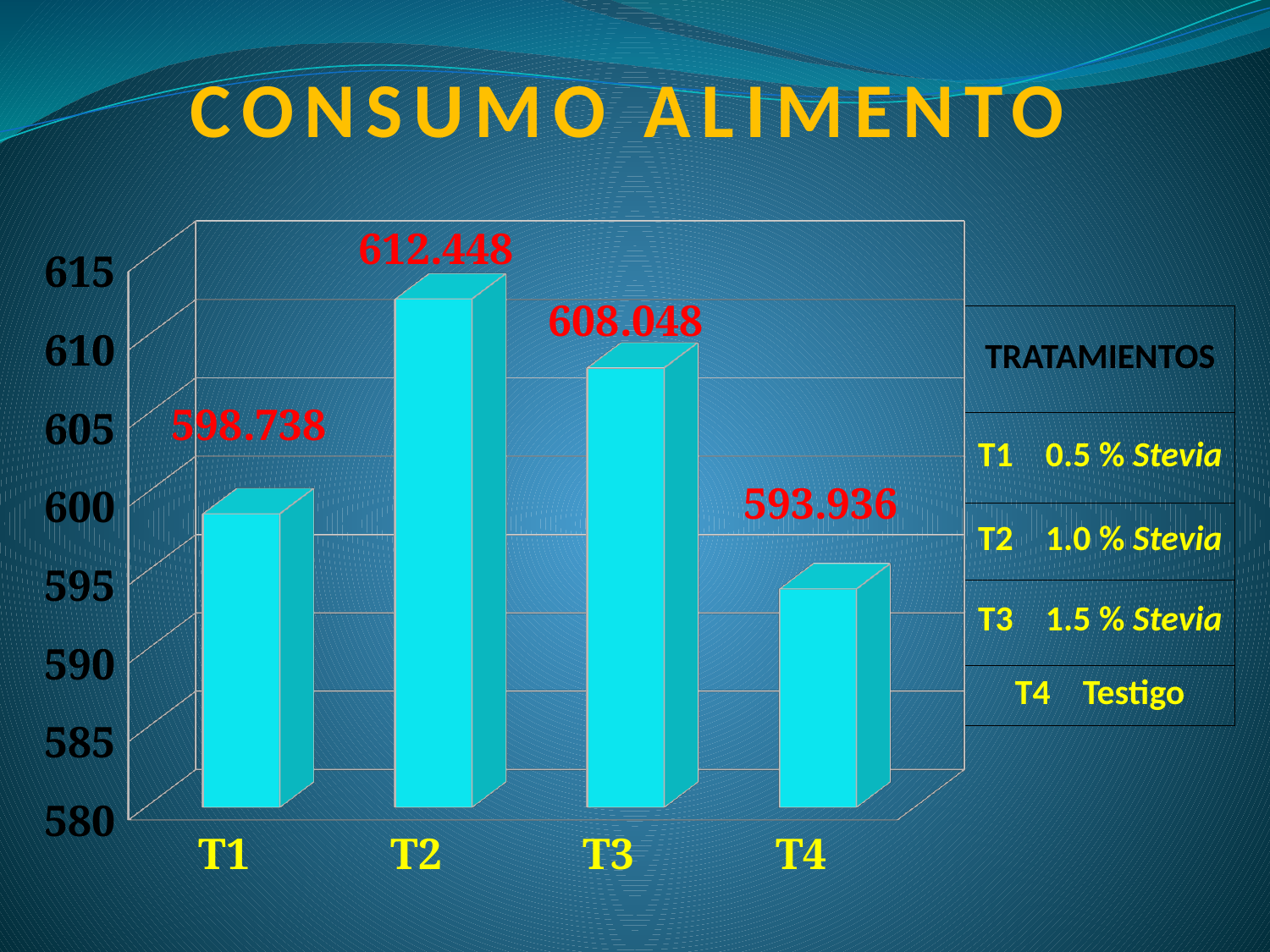
Which category has the lowest value? T4 Is the value for T4 greater or less than 595? less What is the value for T1? 598.738 What is the difference between the values for T2 and T4? 18.512 What is the difference between the values for T2 and T3? 4.400 Which is larger, the value for T1 or the value for T3? T3 What is the value for T4? 593.936 According to the TRATAMIENTOS table, what treatment does T3 correspond to? 1.5 % Stevia What is the value for T2? 612.448 Which category has the highest value? T2 What kind of chart is shown on the slide? bar chart How many categories are shown on the x axis? 4